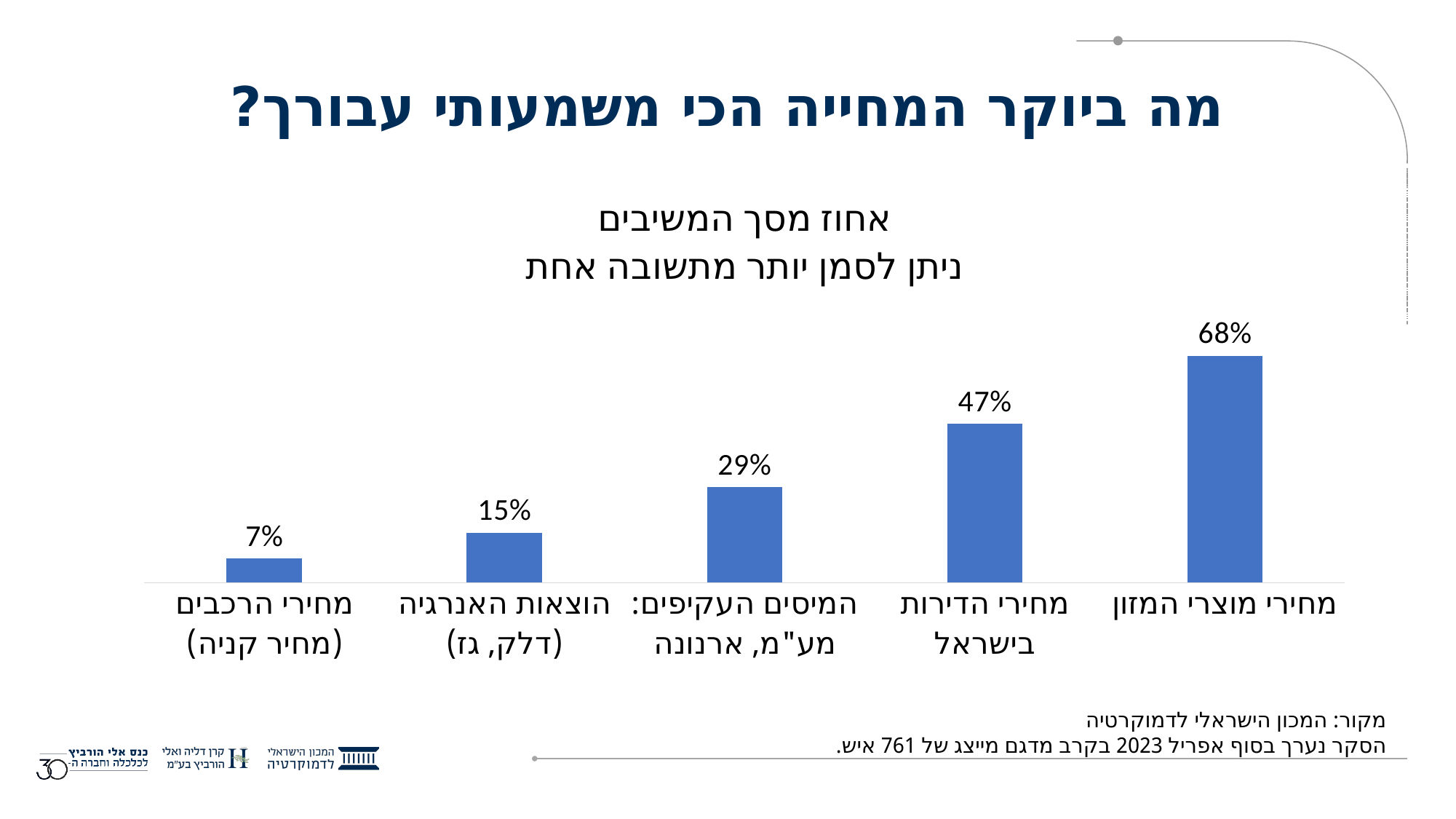
What type of chart is shown on the slide? Bar chart What is the value for הוצאות האנרגיה (דלק, גז)? 15% What is the value shown for מחירי הדירות בישראל? 47% What is the difference between the values for המיסים העקיפים: מע"מ, ארנונה and הוצאות האנרגיה (דלק, גז)? 14% What is the title of the slide? מה ביוקר המחייה הכי משמעותי עבורך? What is the difference between the values for מחירי מוצרי המזון and מחירי הדירות בישראל? 21% Which category has the lowest value? מחירי הרכבים (מחיר קניה) Which is larger: the value for הוצאות האנרגיה (דלק, גז) or the value for מחירי הרכבים (מחיר קניה)? הוצאות האנרגיה (דלק, גז) What percentage is shown for המיסים העקיפים: מע"מ, ארנונה? 29% What percentage of respondents selected מחירי מוצרי המזון? 68% How many categories are shown in the chart? 5 Which category has the highest value? מחירי מוצרי המזון